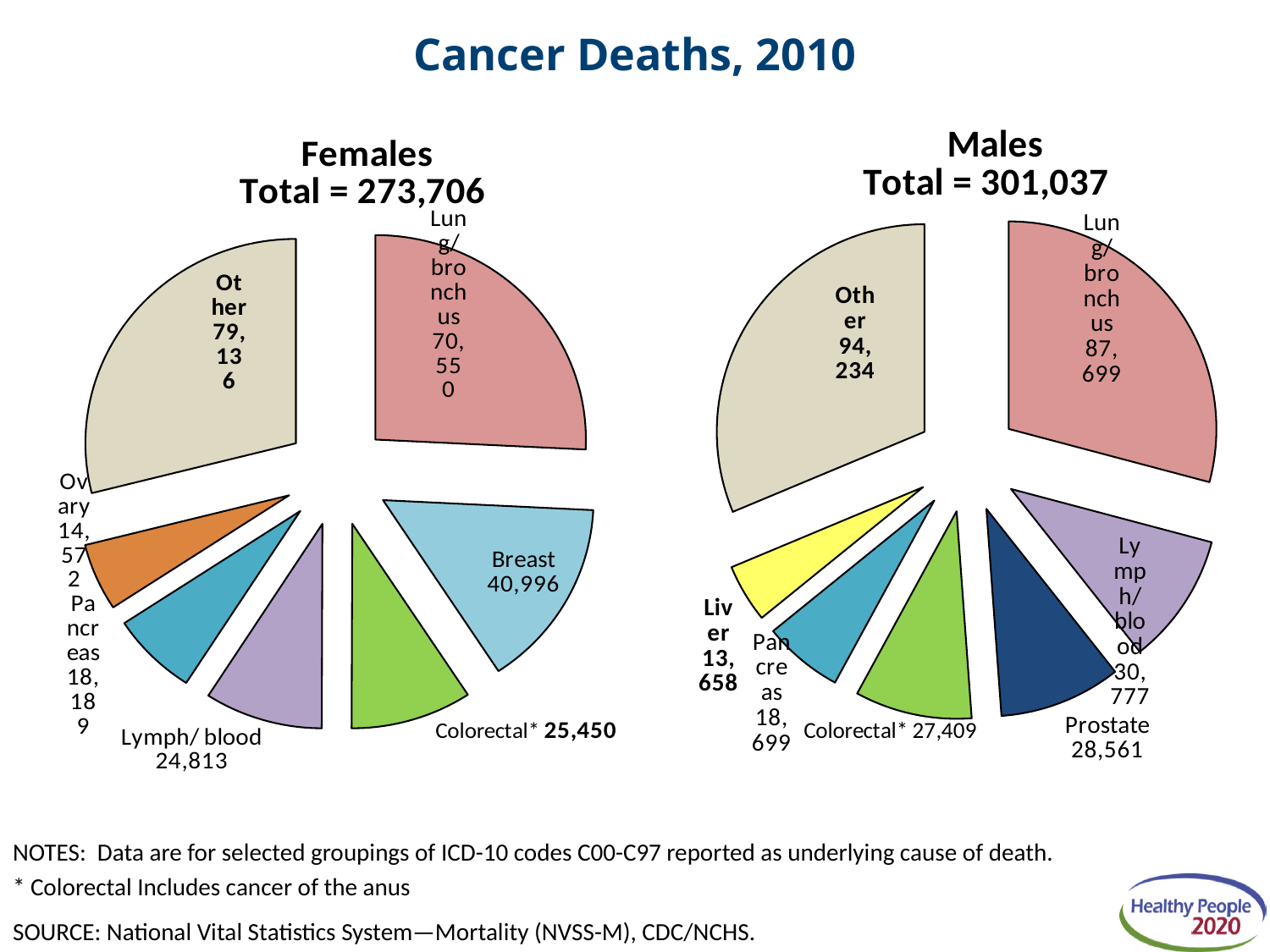
In the Females pie chart, which category has the largest number of deaths? Other In the Males pie chart, which is larger: Lymph/blood or Prostate? Lymph/blood What type of chart is used to show the Males cancer deaths? Pie chart In the Males pie chart, which category has the smallest number of deaths? Liver What is the difference between Lung/bronchus deaths in the Males chart and Lung/bronchus deaths in the Females chart? 17,149 How many slices does the Females pie chart have? 7 In the Females pie chart, which named cancer category has the smallest number of deaths? Ovary In the Males pie chart, what is the value for Liver? 13,658 In the Males pie chart, what is the difference between Prostate and Colorectal* deaths? 1,152 In the Females pie chart, how many deaths are attributed to Lung/bronchus? 70,550 In the Males pie chart, how many deaths are attributed to Prostate cancer? 28,561 In the Females pie chart, what is the value for Breast? 40,996